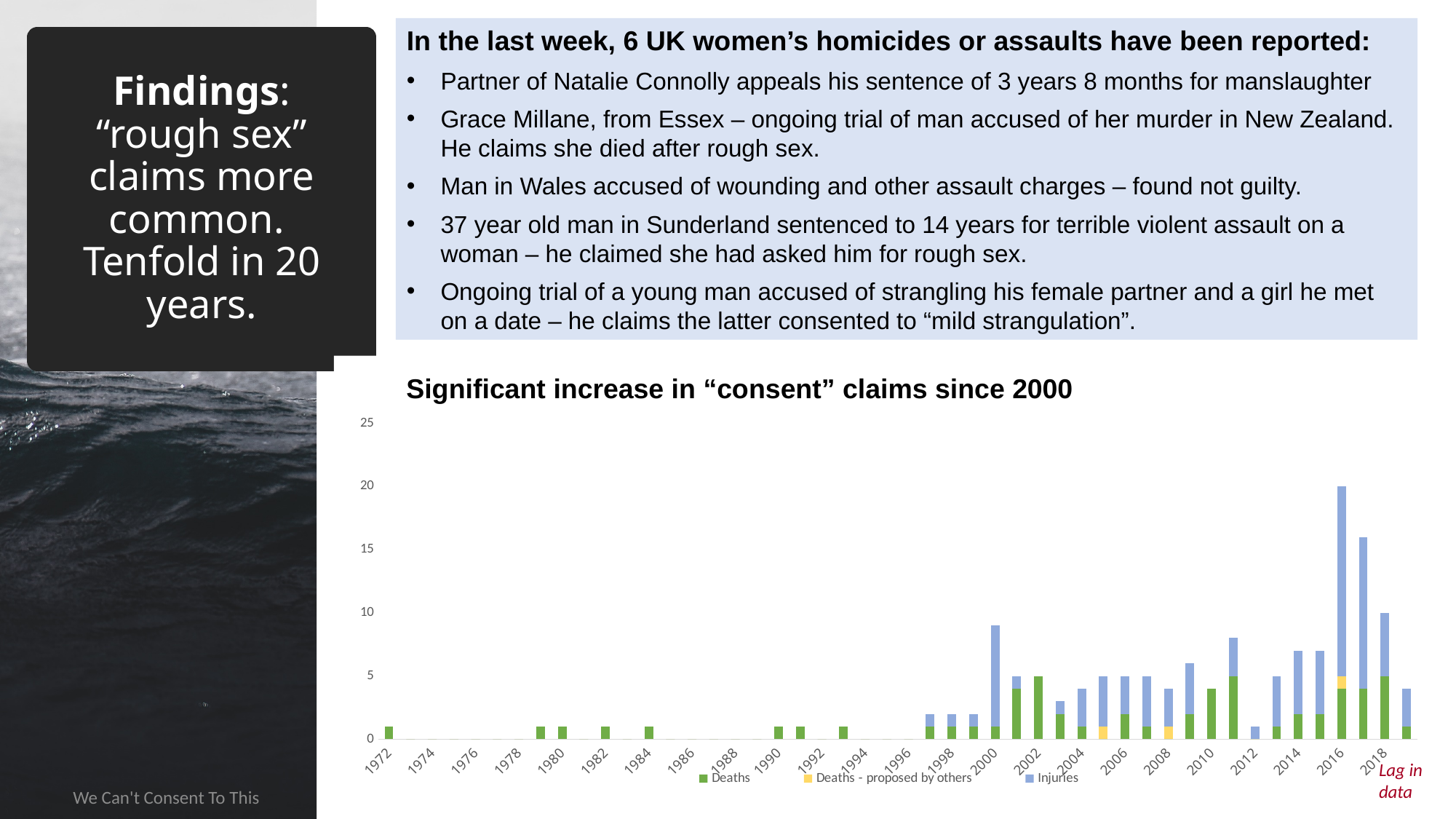
Is the total bar height for 2014 greater or less than 5? greater Is the total bar height for 2016 greater or less than 15? greater What kind of chart is shown under the heading "Significant increase in "consent" claims since 2000"? Stacked bar chart How many series does the chart's legend list? 3 Do the bar heights generally rise or fall from 1972 to 2016? rise Is the total bar height for 2012 greater or less than 5? less Which year has the taller bar, 2000 or 2012? 2000 Which year has the tallest bar in the chart? 2016 Which legend entry is shown in blue? Injuries Which year has the taller bar, 2016 or 2017? 2016 What is the highest value shown on the chart's vertical axis? 25